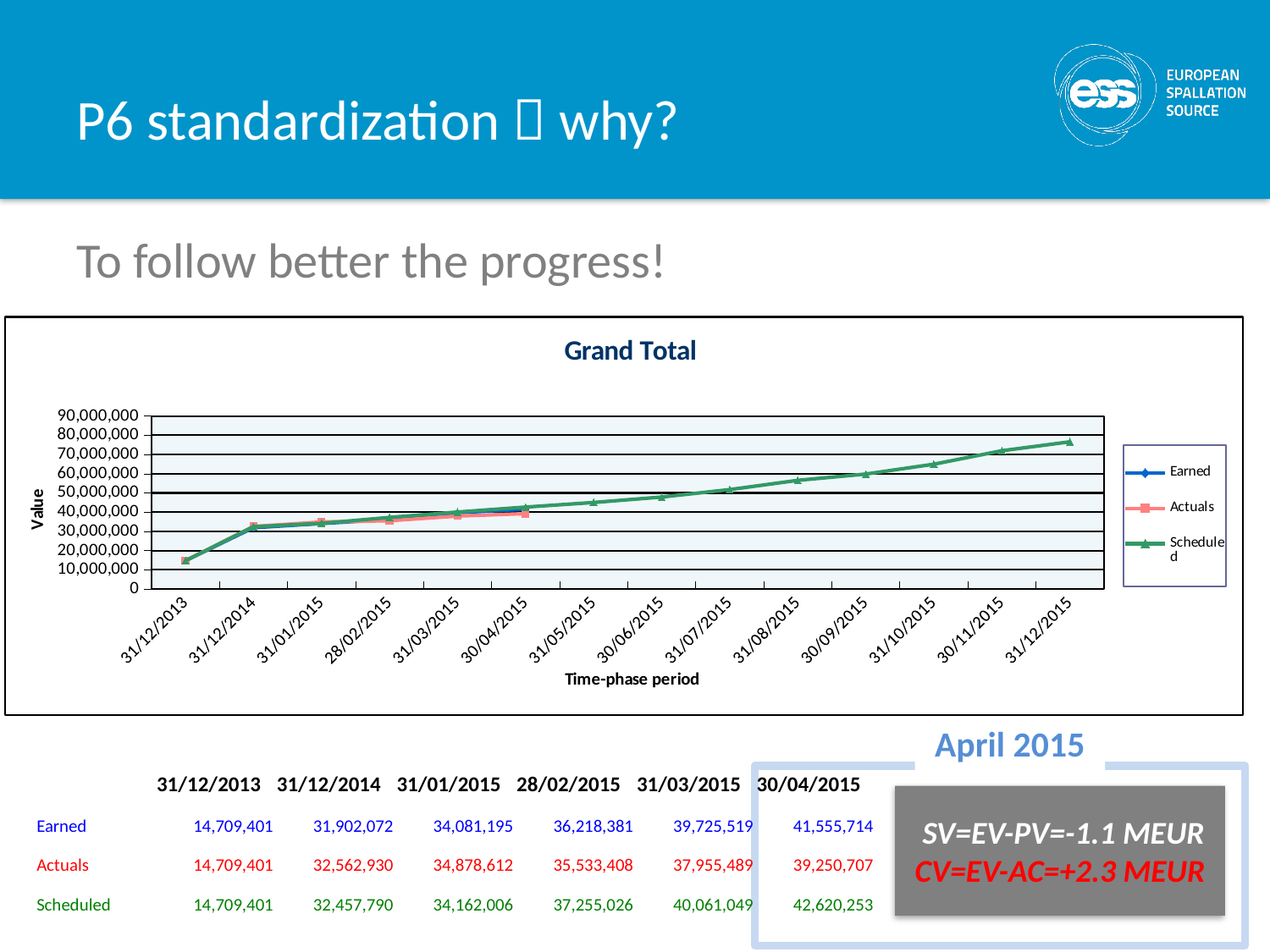
What is the Scheduled value at 28/02/2015? 37,255,026 How many time-phase periods are shown on the x axis of the Grand Total chart? 14 What kind of chart is shown under the title "Grand Total"? Line chart What is the difference between the Earned and Actuals values at 30/04/2015? 2,305,007 What is the Actuals value at 31/03/2015? 37,955,489 At 31/03/2015, which is larger: the Scheduled value or the Earned value? Scheduled Does the Scheduled series rise or fall from 31/12/2013 to 31/12/2015? Rises How many series does the legend of the Grand Total chart list? 3 Which series has the highest value at 30/04/2015? Scheduled Which series has the lowest value at 30/04/2015? Actuals Is the Scheduled value at 31/12/2015 greater or less than 70,000,000? greater What is the Earned value at 30/04/2015? 41,555,714